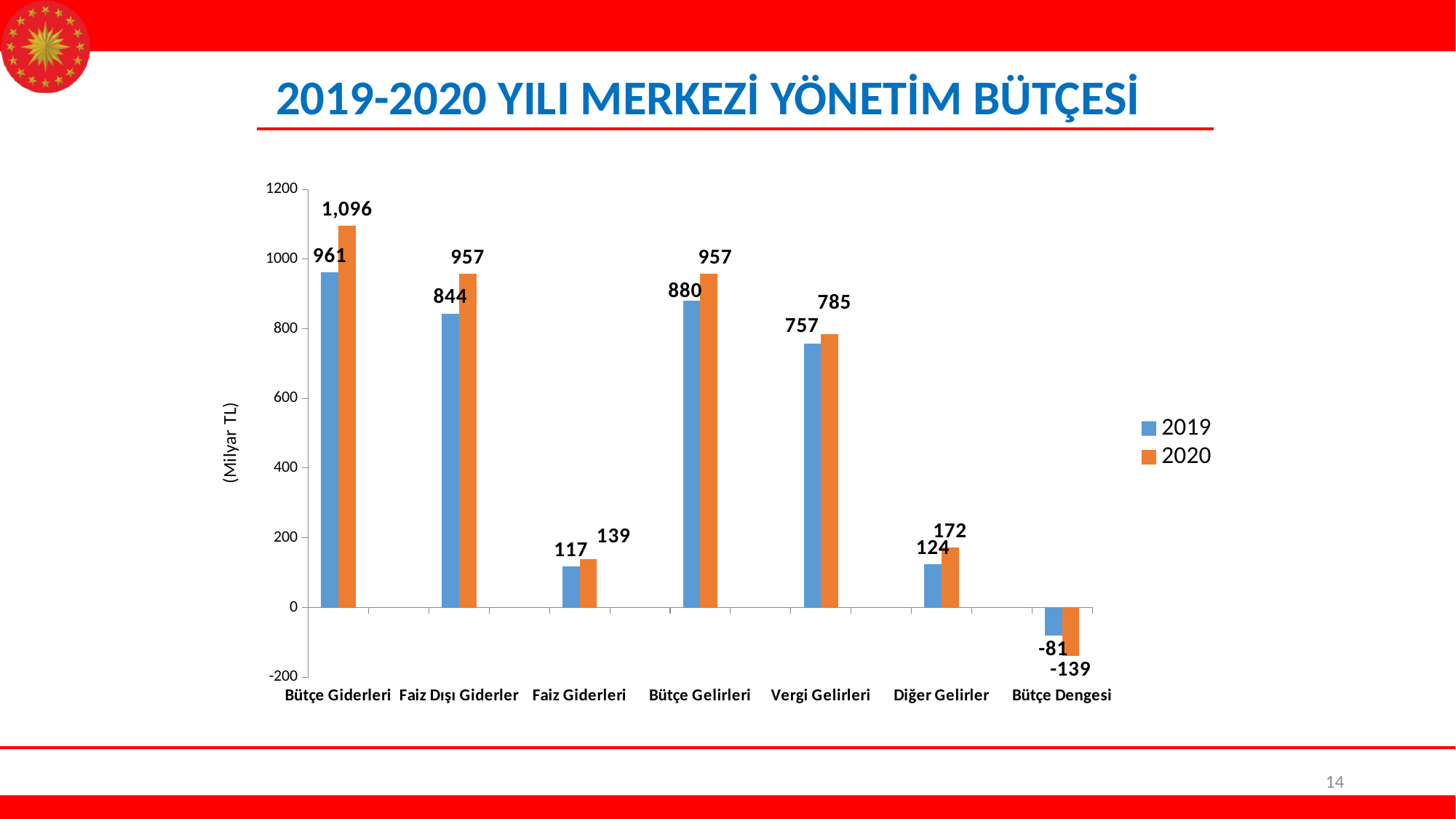
What kind of chart is shown on the slide? bar chart How many categories are shown on the x axis? 7 What is the 2020 value for Bütçe Dengesi? -139 Which category has the highest 2020 value? Bütçe Giderleri What is the 2019 value for Vergi Gelirleri? 757 What unit is shown on the y axis label? Milyar TL Which category has the lowest 2019 value? Bütçe Dengesi Which is larger: the 2019 value for Bütçe Gelirleri or the 2019 value for Faiz Dışı Giderler? Bütçe Gelirleri What is the 2020 value for Bütçe Giderleri? 1,096 What is the difference between the 2020 and 2019 values for Faiz Dışı Giderler? 113 Is the 2020 value for Diğer Gelirler greater or less than 200? less How many series does the legend list? 2